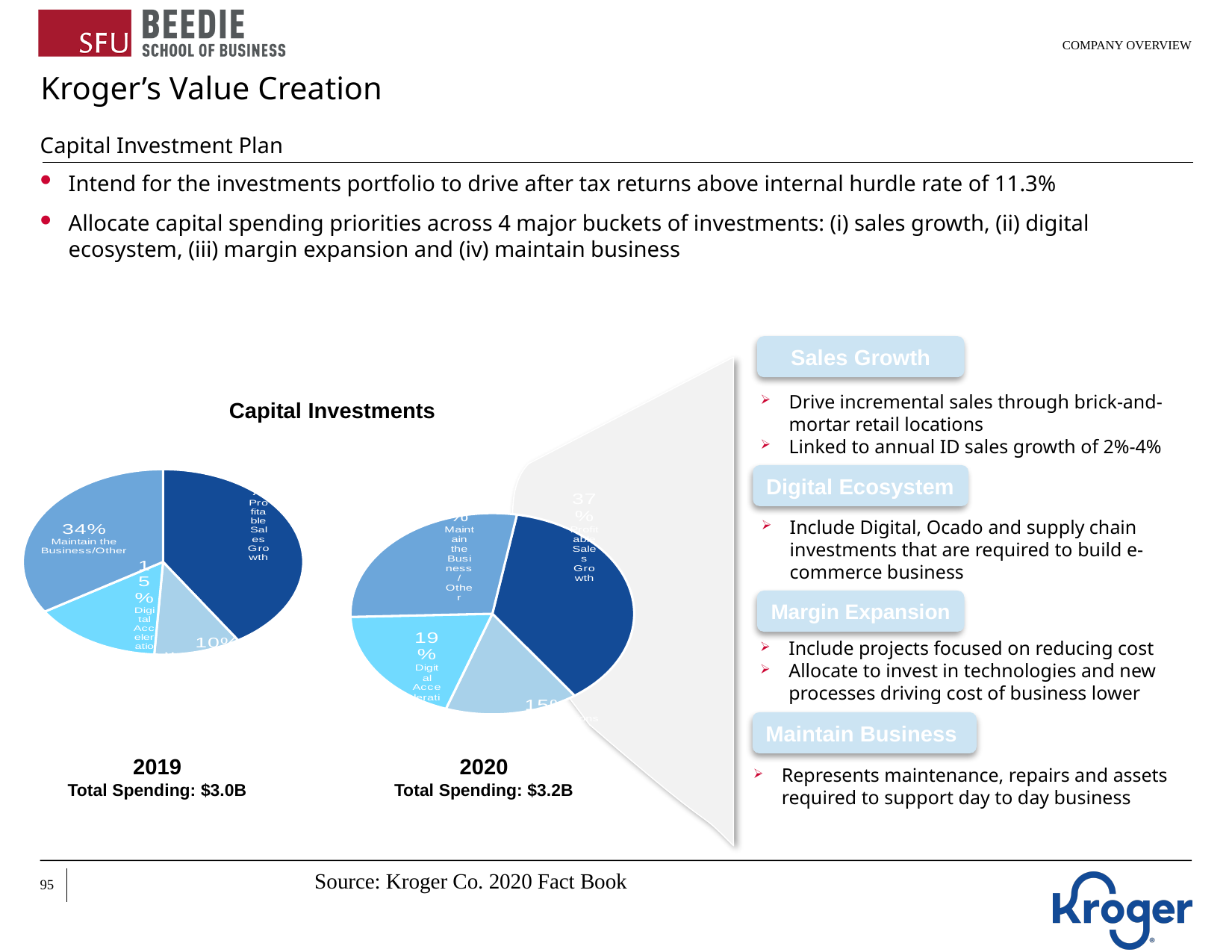
In the 2020 pie chart, what is the difference in percentage points between Profitable Sales Growth and Digital Acceleration? 18 percentage points In the 2019 pie chart, what is the difference in percentage points between Maintain the Business/Other and Digital Acceleration? 19 percentage points In the 2019 pie chart, which is larger: Maintain the Business/Other or Digital Acceleration? Maintain the Business/Other In the 2020 pie chart, which category has the largest slice? Profitable Sales Growth In the 2020 Capital Investments pie chart, what share is Profitable Sales Growth? 37% In the 2020 Capital Investments pie chart, what share is Digital Acceleration? 19% What is the total spending shown under the 2020 pie chart? $3.2B How many slices does the 2020 Capital Investments pie chart have? 4 What is the total spending shown under the 2019 pie chart? $3.0B In the 2019 Capital Investments pie chart, what share is Digital Acceleration? 15% What kind of chart is used to show the 2019 and 2020 Capital Investments? Pie chart In the 2019 Capital Investments pie chart, what share is Maintain the Business/Other? 34%